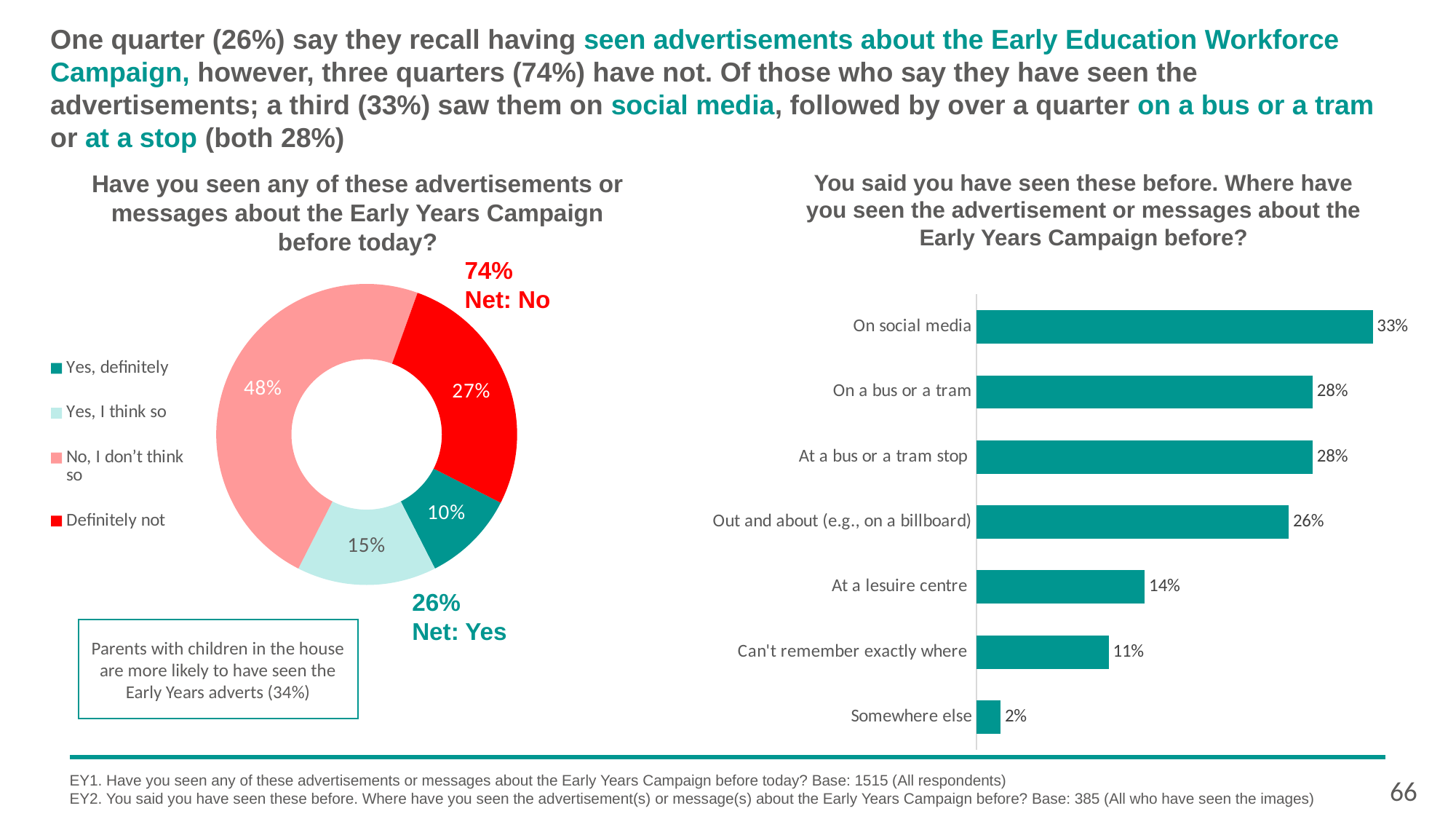
In the right chart (Where have you seen the advertisement...), which location has the highest value? On social media In the left chart (Have you seen any of these advertisements...), what percentage answered 'Yes, definitely'? 10% What type of chart is the left chart (Have you seen any of these advertisements...)? Doughnut chart In the left chart (Have you seen any of these advertisements...), what is the difference between 'Definitely not' and 'Yes, I think so'? 12% In the left chart (Have you seen any of these advertisements...), what is the Net: Yes figure? 26% In the right chart (Where have you seen the advertisement...), what is the value for 'Out and about (e.g., on a billboard)'? 26% In the left chart (Have you seen any of these advertisements...), which response has the largest share? No, I don't think so In the right chart (Where have you seen the advertisement...), how many categories are shown? 7 In the right chart (Where have you seen the advertisement...), what is the difference between 'On social media' and 'At a lesuire centre'? 19% In the left chart (Have you seen any of these advertisements...), what percentage answered 'No, I don't think so'? 48% In the right chart (Where have you seen the advertisement...), which location has the lowest value? Somewhere else In the left chart (Have you seen any of these advertisements...), which response has the smallest share? Yes, definitely